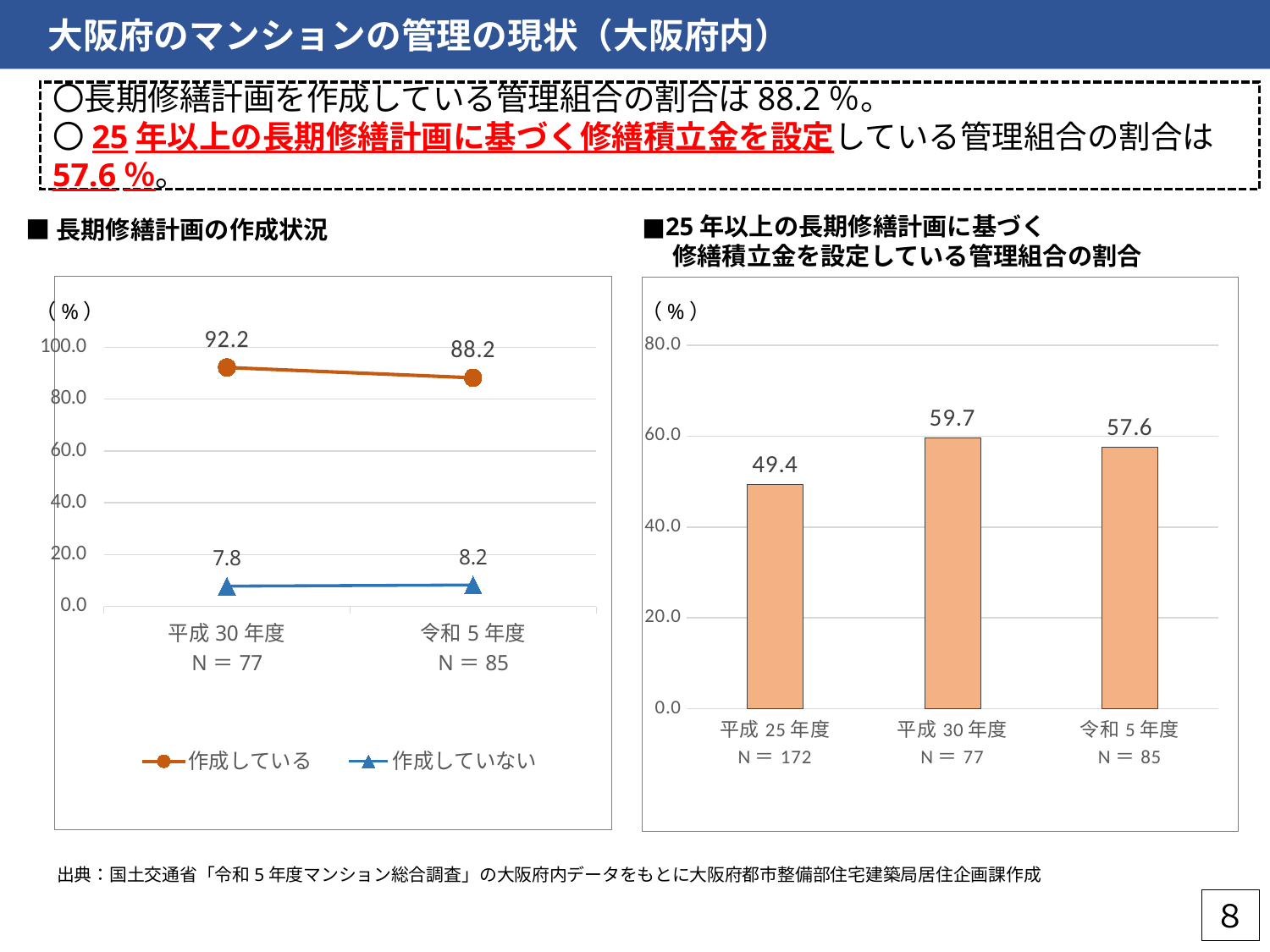
In the right chart (25年以上の長期修繕計画に基づく修繕積立金を設定している管理組合の割合), which year has the lowest value? 平成25年度 In the right chart (25年以上の長期修繕計画に基づく修繕積立金を設定している管理組合の割合), which year has the highest value? 平成30年度 In the left chart (長期修繕計画の作成状況), what is the value for 作成していない in 平成30年度? 7.8 In the right chart (25年以上の長期修繕計画に基づく修繕積立金を設定している管理組合の割合), what is the difference between 平成30年度 and 令和5年度? 2.1 In the left chart (長期修繕計画の作成状況), does the 作成している series rise or fall from 平成30年度 to 令和5年度? fall In the left chart (長期修繕計画の作成状況), what kind of chart is it? line chart In the right chart (25年以上の長期修繕計画に基づく修繕積立金を設定している管理組合の割合), how many bars are shown? 3 In the left chart (長期修繕計画の作成状況), what is the value for 作成している in 令和5年度? 88.2 In the right chart (25年以上の長期修繕計画に基づく修繕積立金を設定している管理組合の割合), what is the value for 平成25年度? 49.4 In the right chart (25年以上の長期修繕計画に基づく修繕積立金を設定している管理組合の割合), what kind of chart is it? bar chart In the left chart (長期修繕計画の作成状況), how many series does the legend list? 2 In the left chart (長期修繕計画の作成状況), by how much did the 作成している value change from 平成30年度 to 令和5年度? 4.0